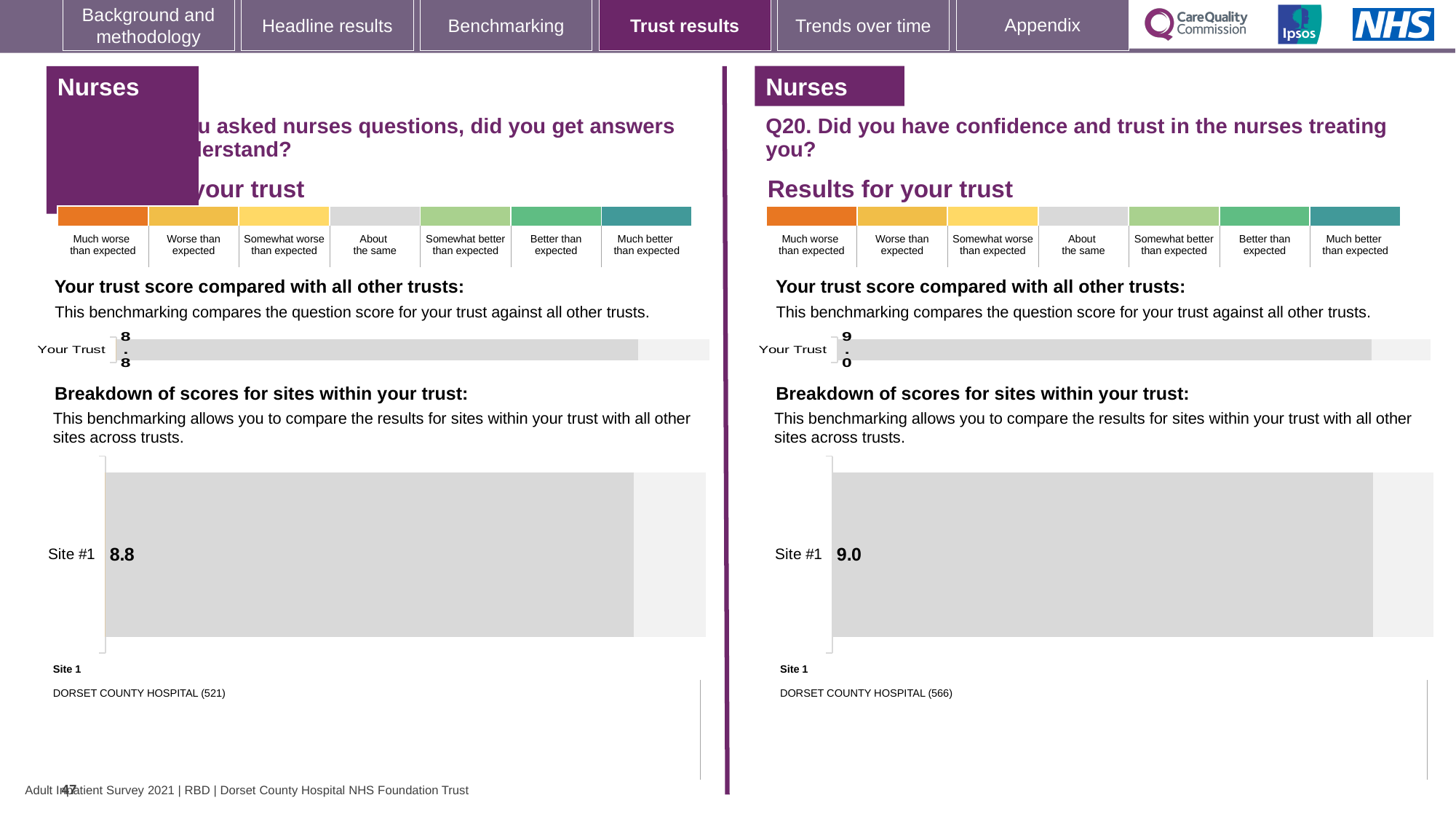
How many sites are shown in the site breakdown chart on the left half of the slide? 1 On the right half of the slide (Q20), which hospital is listed as Site 1? DORSET COUNTY HOSPITAL (566) How many sites are shown in the site breakdown chart on the right half of the slide (Q20)? 1 On the right half of the slide (Q20), is the Your Trust score equal to the Site #1 score? Yes On the left half of the slide, what is the score shown for Site #1? 8.8 What is the difference between the Your Trust score on the right half (Q20) and the Your Trust score on the left half of the slide? 0.2 On the left half of the slide, what is the score shown for Your Trust? 8.8 On the right half of the slide (Q20), what is the score shown for Your Trust? 9.0 What kind of chart is used to show the Site #1 score on the right half of the slide (Q20)? Bar chart On the left half of the slide, which hospital is listed as Site 1? DORSET COUNTY HOSPITAL (521) On the right half of the slide (Q20), what is the score shown for Site #1? 9.0 Which is larger: the Site #1 score on the left half of the slide or the Site #1 score on the right half (Q20)? Site #1 on the right half (Q20)